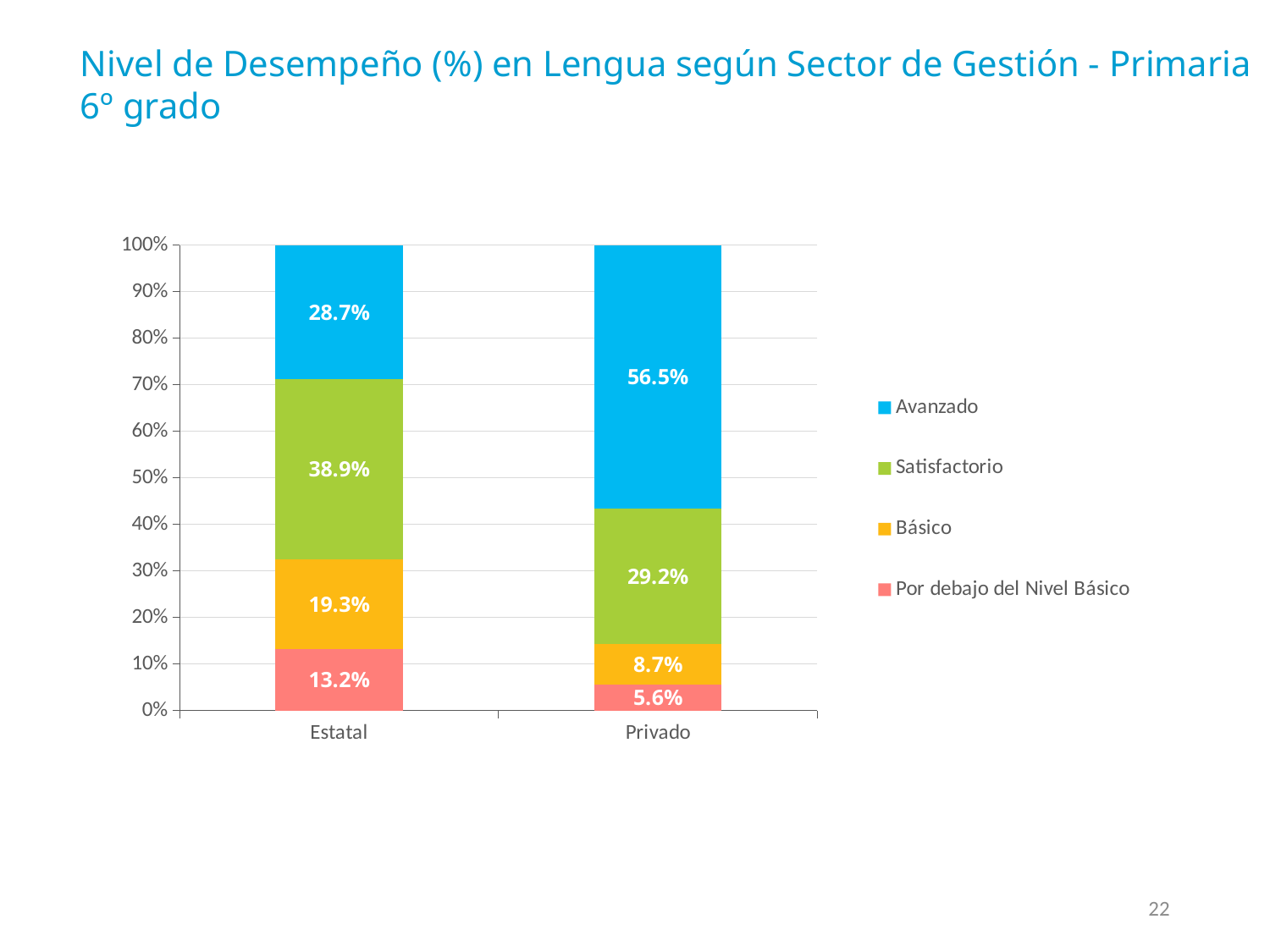
What is the Avanzado value for Privado? 56.5% Which category has the higher Por debajo del Nivel Básico value, Estatal or Privado? Estatal What is the Básico value for Privado? 8.7% What is the difference between the Básico values for Estatal and Privado? 10.6 percentage points What is the Por debajo del Nivel Básico value for Estatal? 13.2% What is the Satisfactorio value for Estatal? 38.9% How many series does the legend list? 4 Which series is the largest segment in the Estatal bar? Satisfactorio What kind of chart is shown on the slide? Stacked bar chart What is the difference between the Avanzado values for Privado and Estatal? 27.8 percentage points Which category has the higher Avanzado value, Estatal or Privado? Privado How many categories are shown on the x axis? 2